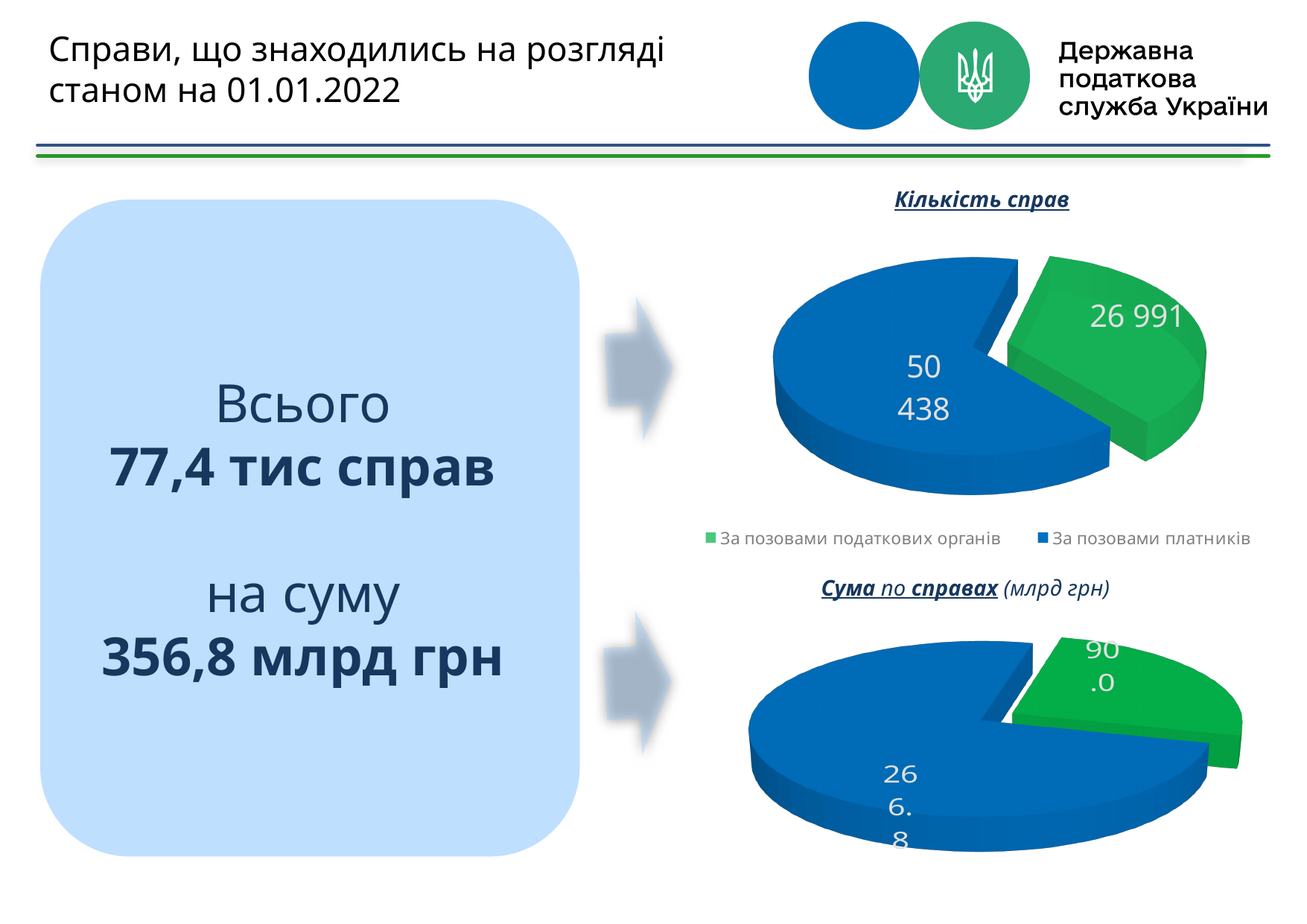
In the 'Кількість справ' chart, what is the difference between the two slices? 23 447 In the 'Кількість справ' chart, which category has the smallest slice? За позовами податкових органів In the 'Кількість справ' chart, what is the value for 'За позовами податкових органів'? 26 991 In the 'Кількість справ' chart, how many slices does the pie have? 2 In the 'Сума по справах (млрд грн)' chart, what is the value of the blue slice? 266.8 How many series does the legend under the 'Кількість справ' chart list? 2 What type of chart is the 'Кількість справ' chart? Pie chart In the 'Сума по справах (млрд грн)' chart, which slice is larger, the blue one or the green one? The blue one In the 'Кількість справ' chart, which category has the largest slice? За позовами платників In the 'Сума по справах (млрд грн)' chart, what is the value of the green slice? 90.0 Which colour represents 'За позовами податкових органів' in the legend? Green In the 'Кількість справ' chart, what is the value for 'За позовами платників'? 50 438